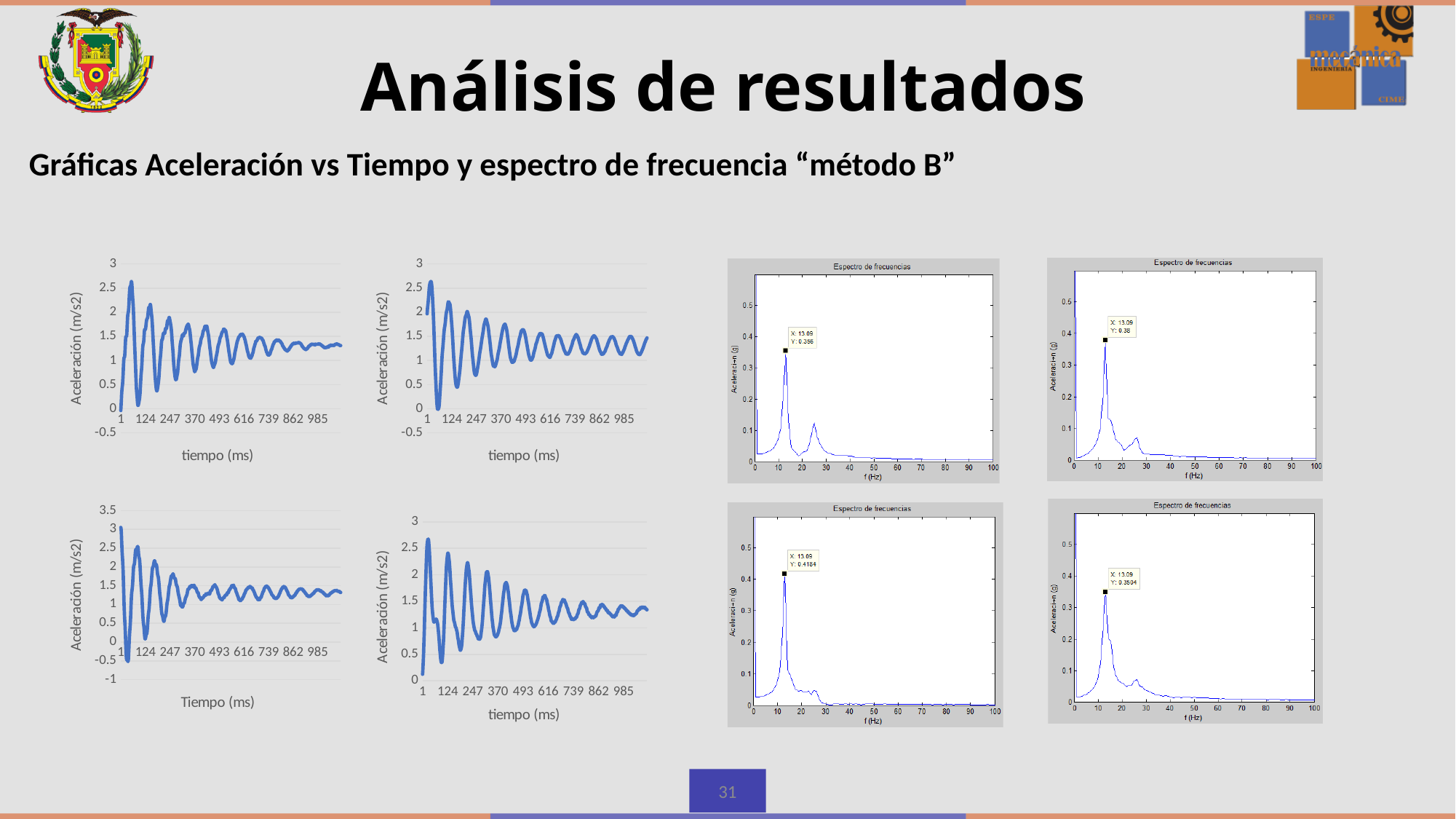
In the bottom-left 'Espectro de frecuencias' plot, what is the Y value shown in the data tip at the marked peak? 0.4184 In the bottom-right 'Espectro de frecuencias' plot, what is the Y value shown in the data tip at the marked peak? 0.3504 What is the difference between the marked peak Y values of the bottom-left (0.4184) and bottom-right (0.3504) 'Espectro de frecuencias' plots? 0.068 Which marked peak Y value is larger: the top-left 'Espectro de frecuencias' plot or the top-right one? top-right (0.38) Among the four 'Espectro de frecuencias' plots, which one has the lowest marked peak Y value? bottom-right (0.3504) In the top-left Aceleración vs tiempo chart, does the amplitude of the oscillation rise or fall as time increases? fall In the top-left 'Espectro de frecuencias' plot, what is the Y value shown in the data tip at the marked peak? 0.356 In the top-right 'Espectro de frecuencias' plot, what is the X value shown in the data tip at the marked peak? 13.09 Among the four 'Espectro de frecuencias' plots, which one has the highest marked peak Y value? bottom-left (0.4184) How many Aceleración vs tiempo line charts are shown on the left side of the slide? 4 What kind of chart is the top-left Aceleración vs tiempo chart? line chart What is the x-axis label of the 'Espectro de frecuencias' plots? f (Hz)